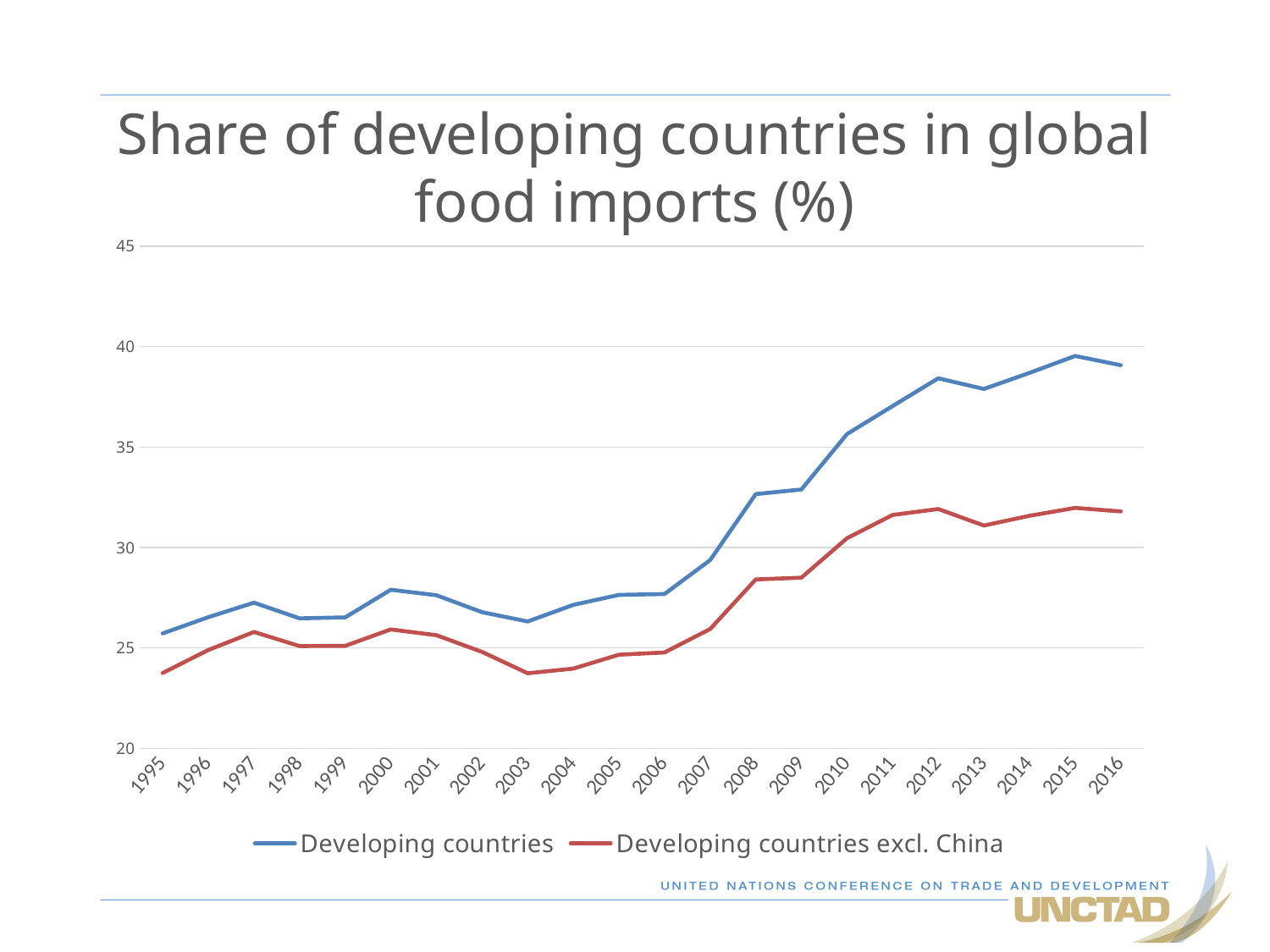
Is the value for Developing countries excl. China in 1995 greater or less than 25? less Is the value for Developing countries in 2012 greater or less than 40? less What kind of chart is shown on the slide? line chart In 2010, which series has the larger value, Developing countries or Developing countries excl. China? Developing countries Is the value for Developing countries excl. China in 2003 greater or less than 25? less How many years are plotted along the x axis? 22 What is the title of the chart? Share of developing countries in global food imports (%) Which series is drawn in red? Developing countries excl. China Overall, do the values for Developing countries rise or fall from 1995 to 2016? rise How many series does the legend list? 2